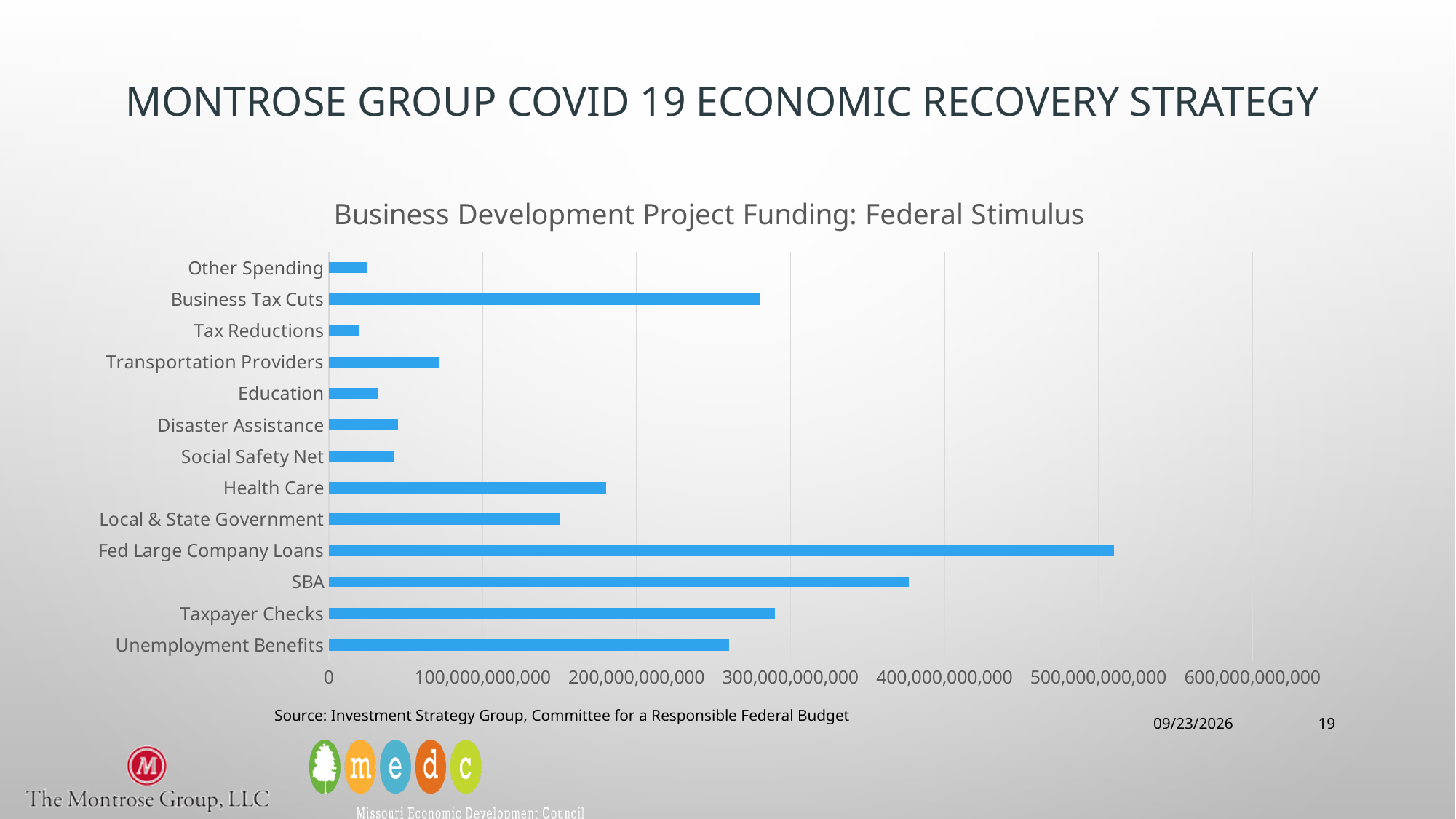
How many categories are plotted in the chart? 13 Is the value for Transportation Providers greater or less than 100,000,000,000? less Is the value for SBA greater or less than 300,000,000,000? greater Which is larger, the value for SBA or the value for Taxpayer Checks? SBA What is the title of the chart? Business Development Project Funding: Federal Stimulus Which is larger, the value for Health Care or the value for Local & State Government? Health Care Is the value for Health Care greater or less than 200,000,000,000? less Which category has the highest value in the chart? Fed Large Company Loans What kind of chart is shown on the slide? Bar chart